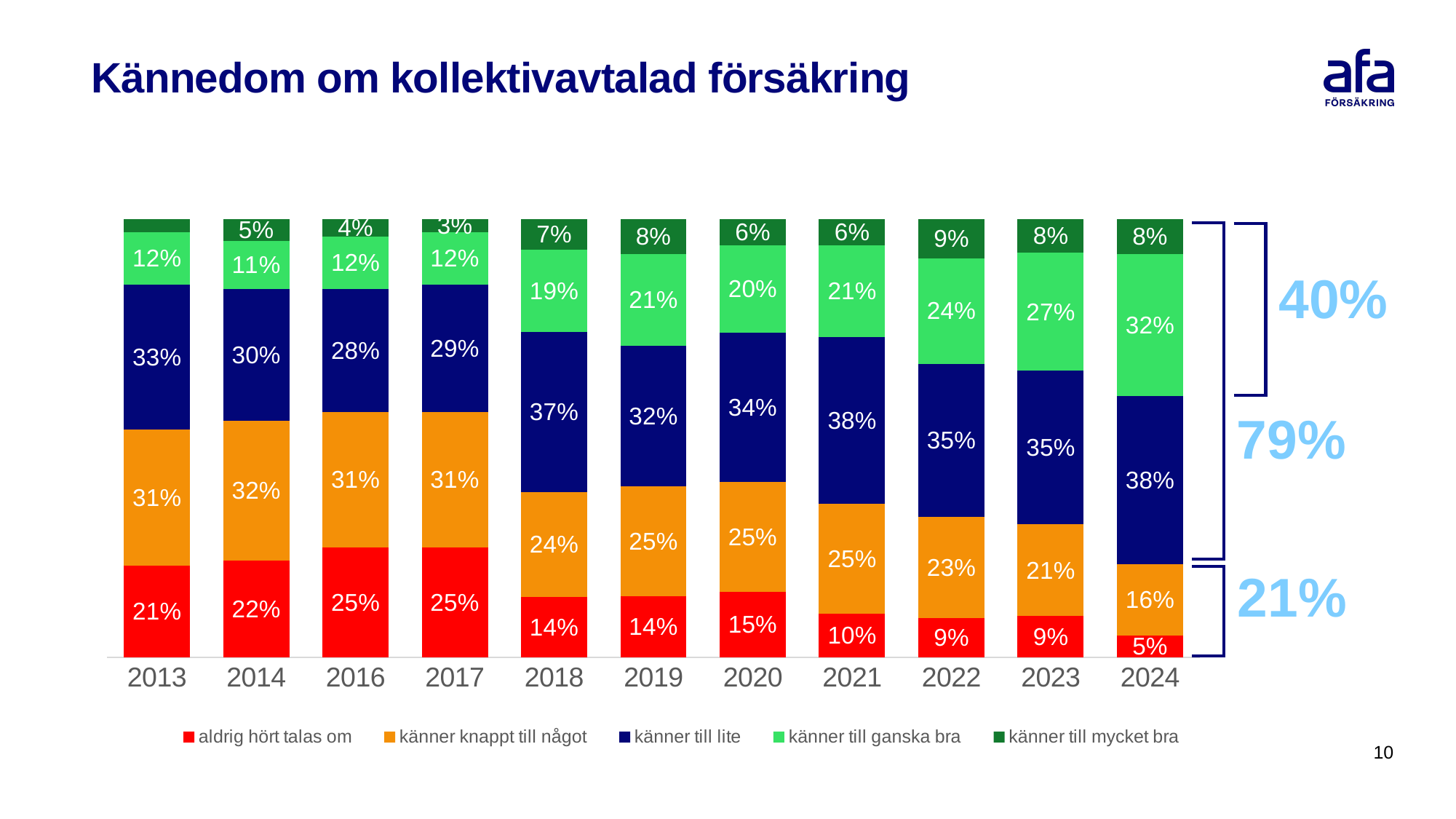
In which year is the value for "känner till ganska bra" highest? 2024 In which year is the value for "aldrig hört talas om" lowest? 2024 What kind of chart is shown on the slide? Stacked bar chart Which year has the larger value for "känner till lite", 2018 or 2019? 2018 How many years are shown on the x axis? 11 What is the value for "känner till ganska bra" in 2018? 19% What is the value for "aldrig hört talas om" in 2024? 5% What is the value for "känner till mycket bra" in 2022? 9% How many series does the legend list? 5 What is the difference between the "känner till ganska bra" values for 2024 and 2013? 20 percentage points What is the value for "känner till lite" in 2021? 38% Does the value for "aldrig hört talas om" rise or fall from 2017 to 2024? Fall